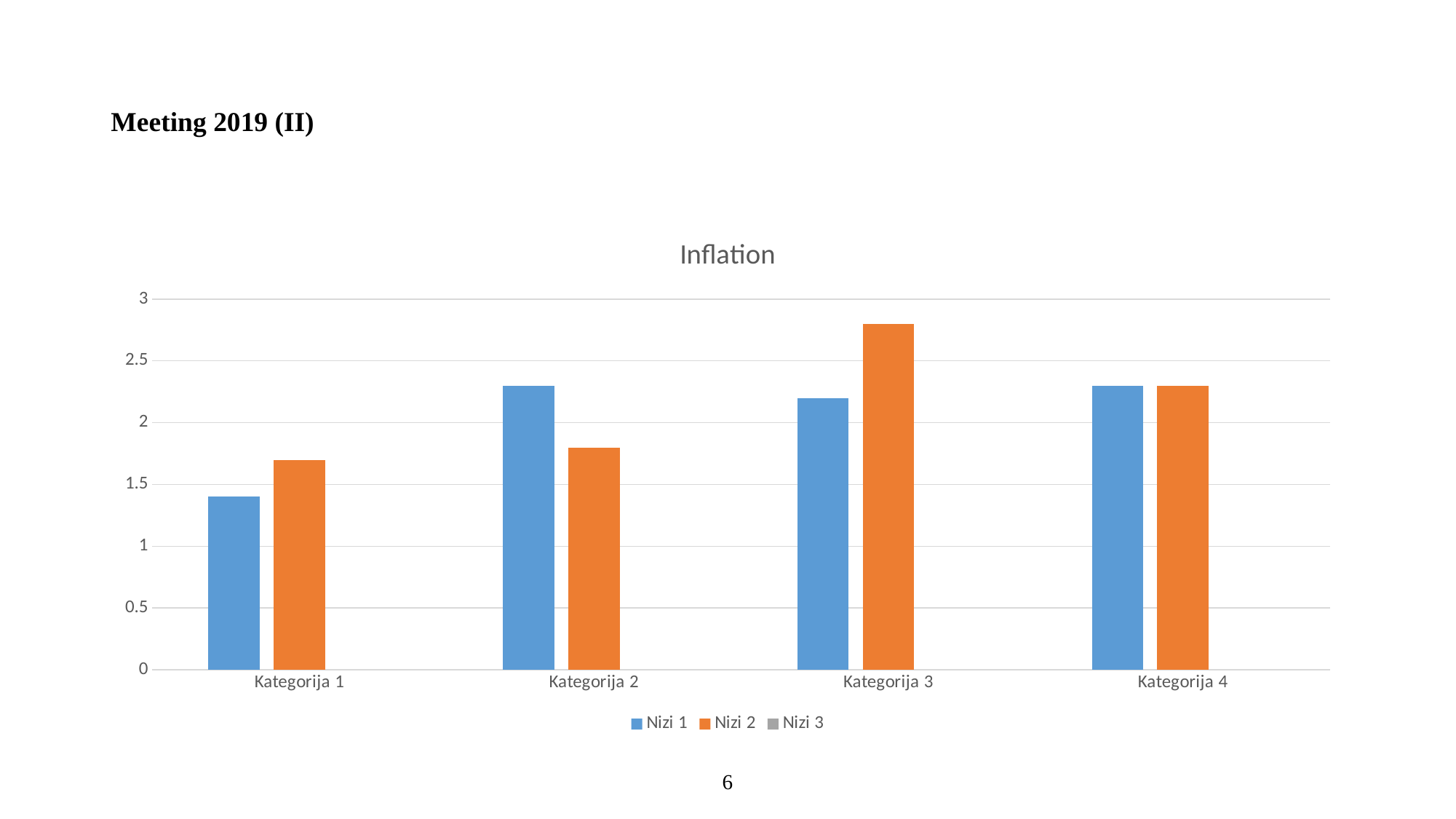
Is the Nizi 2 value for Kategorija 2 greater or less than 2? less For which category is the Nizi 1 value lowest? Kategorija 1 What kind of chart is shown on the slide? bar chart How many categories are shown on the x axis of the chart? 4 In Kategorija 2, which series has the larger value, Nizi 1 or Nizi 2? Nizi 1 How many series does the legend of the chart list? 3 In Kategorija 3, which series has the larger value, Nizi 1 or Nizi 2? Nizi 2 Is the Nizi 2 value for Kategorija 3 greater or less than 2.5? greater What is the title of the chart? Inflation For which category is the Nizi 2 value highest? Kategorija 3 Is the Nizi 1 value for Kategorija 1 greater or less than 1.5? less In Kategorija 1, which series has the larger value, Nizi 1 or Nizi 2? Nizi 2